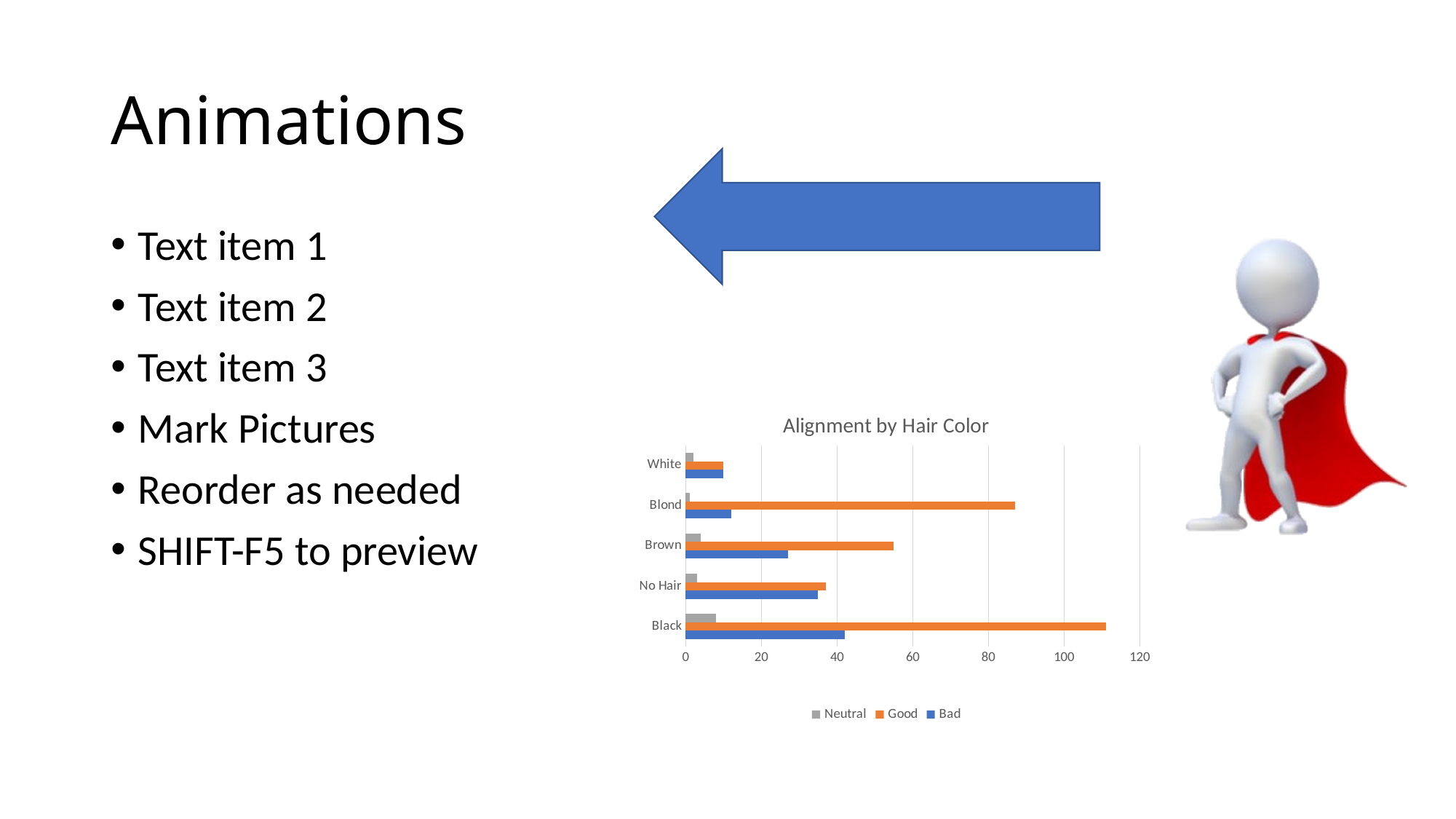
What kind of chart is shown on the slide? bar chart Is the Good value for Blond greater or less than 80? greater Which hair color has the lowest Good value? White How many hair color categories are shown on the chart? 5 Which hair color has the highest Good value? Black Is the Good value for Black greater or less than 100? greater What is the title of the chart? Alignment by Hair Color Which hair color has the highest Bad value? Black Which series is shown in orange in the chart? Good How many series does the chart legend list? 3 Which is larger, the Good value for Brown or the Good value for No Hair? Good value for Brown Is the Bad value for Brown greater or less than 40? less